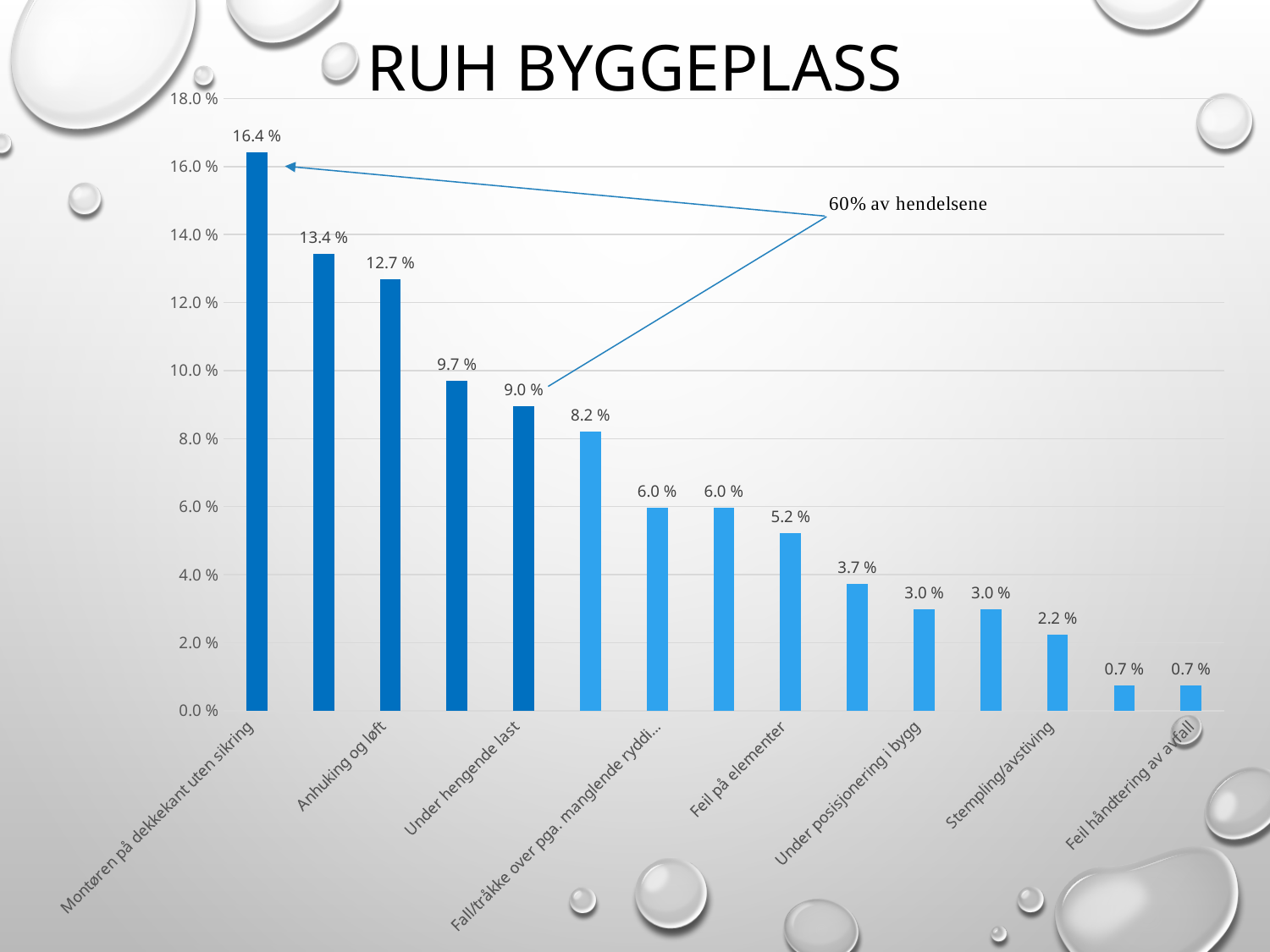
What type of chart is shown on the slide? Bar chart What is the title of the chart? RUH BYGGEPLASS What is the value for 'Anhuking og løft'? 12.7 % Which is larger, 'Feil på elementer' or 'Under posisjonering i bygg'? Feil på elementer What is the value for 'Montøren på dekkekant uten sikring'? 16.4 % What is the value for 'Under hengende last'? 9.0 % How many bars are plotted in the chart? 15 What is the value for 'Feil på elementer'? 5.2 % What is the difference between 'Montøren på dekkekant uten sikring' and 'Anhuking og løft'? 3.7 % What is the value for 'Stempling/avstiving'? 2.2 % Do the values rise or fall from left to right along the x axis? Fall Which category has the highest value? Montøren på dekkekant uten sikring